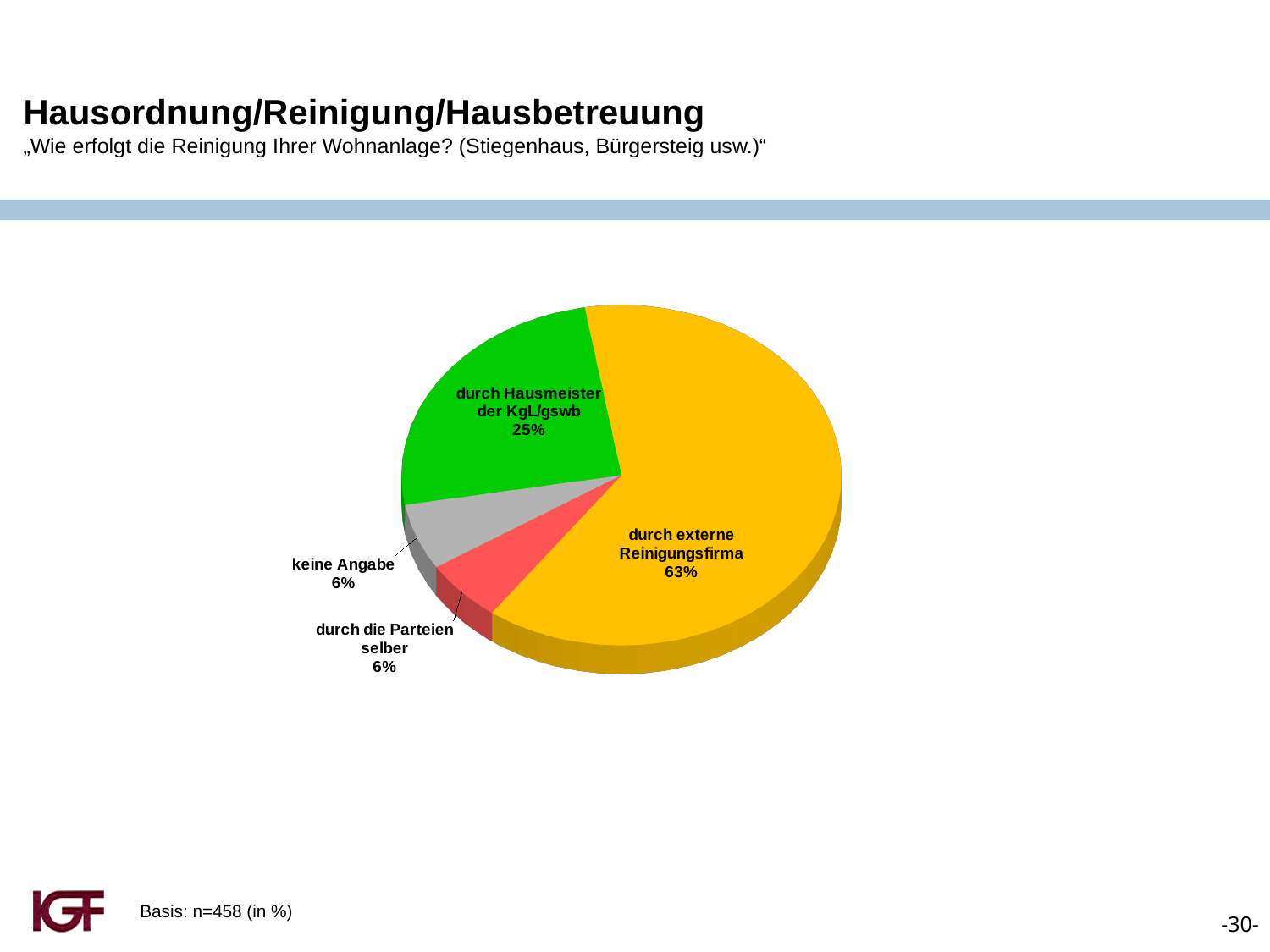
What is the combined share of 'durch die Parteien selber' and 'keine Angabe'? 12% Which category has the largest slice of the pie? durch externe Reinigungsfirma Which is larger: the share for 'durch Hausmeister der KgL/gswb' or the share for 'keine Angabe'? durch Hausmeister der KgL/gswb How many slices does the pie chart have? 4 What percentage is labelled for 'durch die Parteien selber'? 6% What percentage is shown for 'keine Angabe'? 6% What is the sample size (Basis) stated on the slide? n=458 What is the difference in percentage points between 'durch externe Reinigungsfirma' and 'durch Hausmeister der KgL/gswb'? 38 What share is shown for 'durch Hausmeister der KgL/gswb'? 25% What colour is the slice for 'durch Hausmeister der KgL/gswb'? green What percentage of respondents said cleaning is done by an external cleaning company (durch externe Reinigungsfirma)? 63% What type of chart is shown on the slide? pie chart